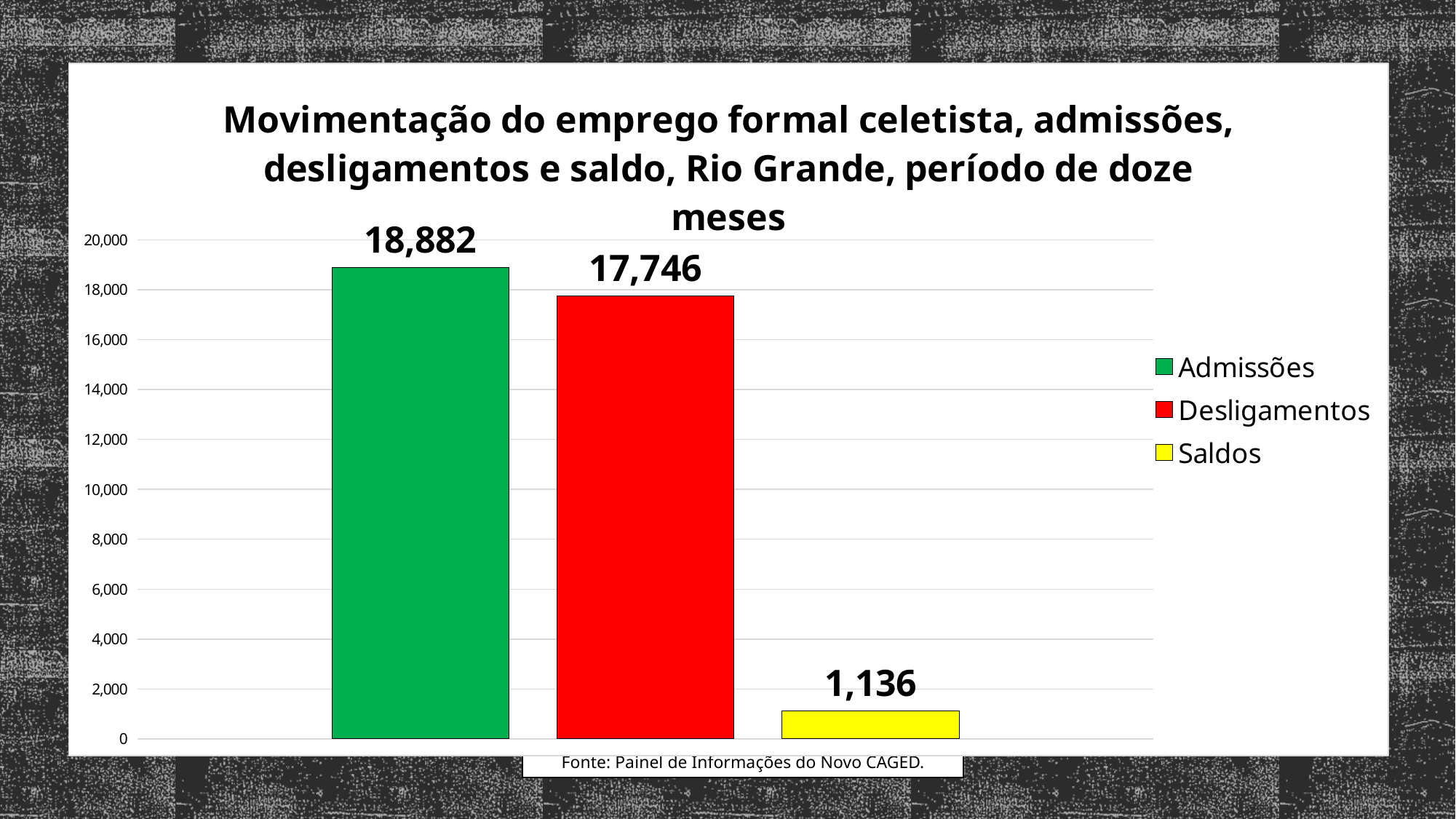
Which series has the highest value? Admissões What colour is the bar for Saldos? yellow How many series does the legend list? 3 What kind of chart is shown on the slide? bar chart Which series has the lowest value? Saldos What is the value for Saldos? 1,136 How many bars are plotted on the chart? 3 What is the value for Desligamentos? 17,746 What is the difference between Admissões and Desligamentos? 1,136 Is the value for Desligamentos greater or less than 16,000? greater What is the value for Admissões? 18,882 Which is larger, Desligamentos or Saldos? Desligamentos